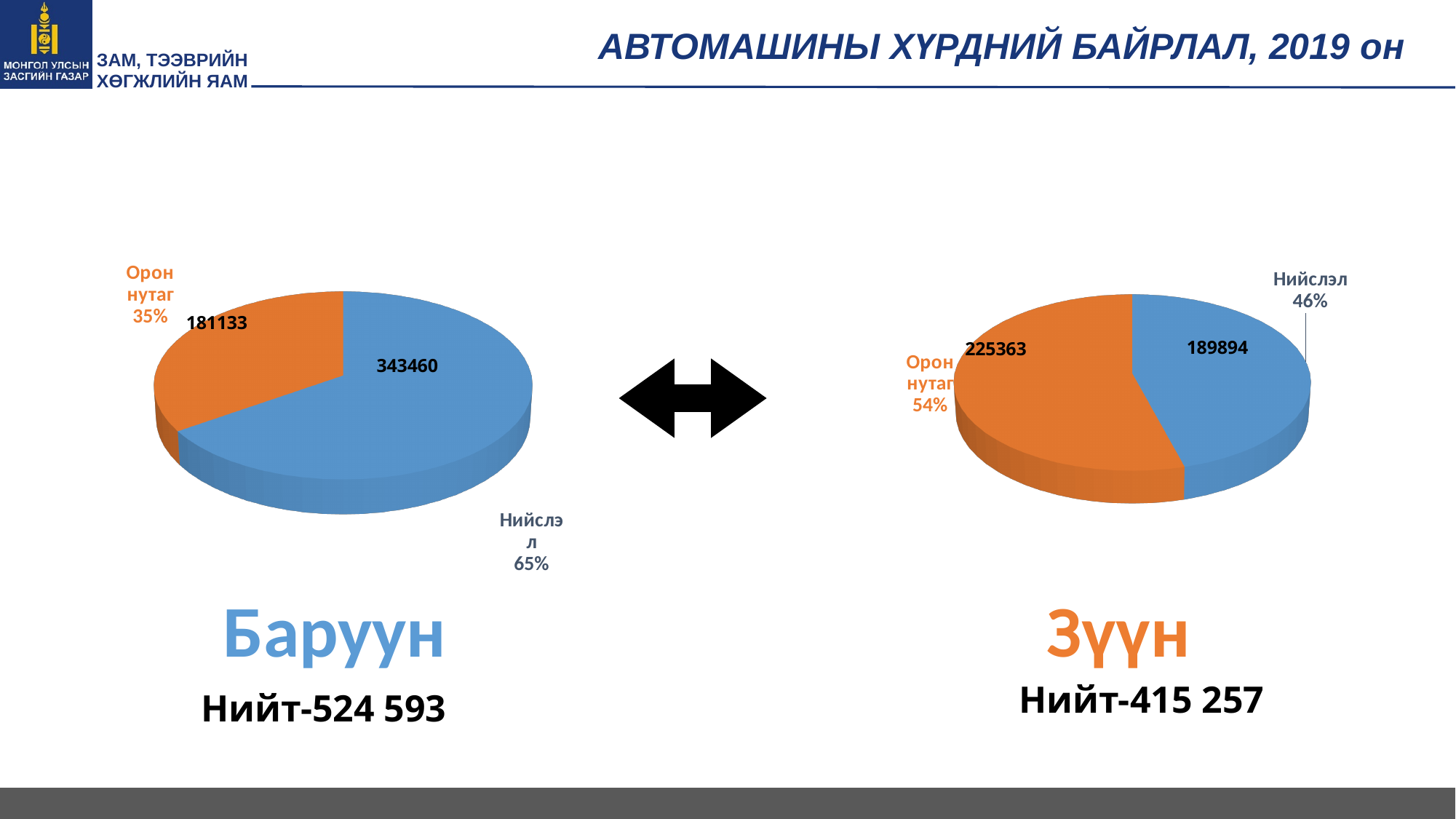
In the left pie chart (Баруун), which slice is the largest? Нийслэл Which is larger: Орон нутаг in the left chart (Баруун) or Орон нутаг in the right chart (Зүүн)? Орон нутаг in the right chart (Зүүн) In the right pie chart (Зүүн), which slice is the smallest? Нийслэл In the right pie chart (Зүүн), what is the value for Орон нутаг? 225363 In the left pie chart (Баруун), what share of the pie does Нийслэл take? 65% In the left pie chart (Баруун), what is the value for Нийслэл? 343460 How many slices does each pie chart on the slide have? 2 In the left pie chart (Баруун), what is the value for Орон нутаг? 181133 In the right pie chart (Зүүн), what share of the pie does Орон нутаг take? 54% What kind of chart is used for the Баруун (left) data? pie chart In the right pie chart (Зүүн), what is the value for Нийслэл? 189894 In the left pie chart (Баруун), what is the difference between the Нийслэл and Орон нутаг values? 162327